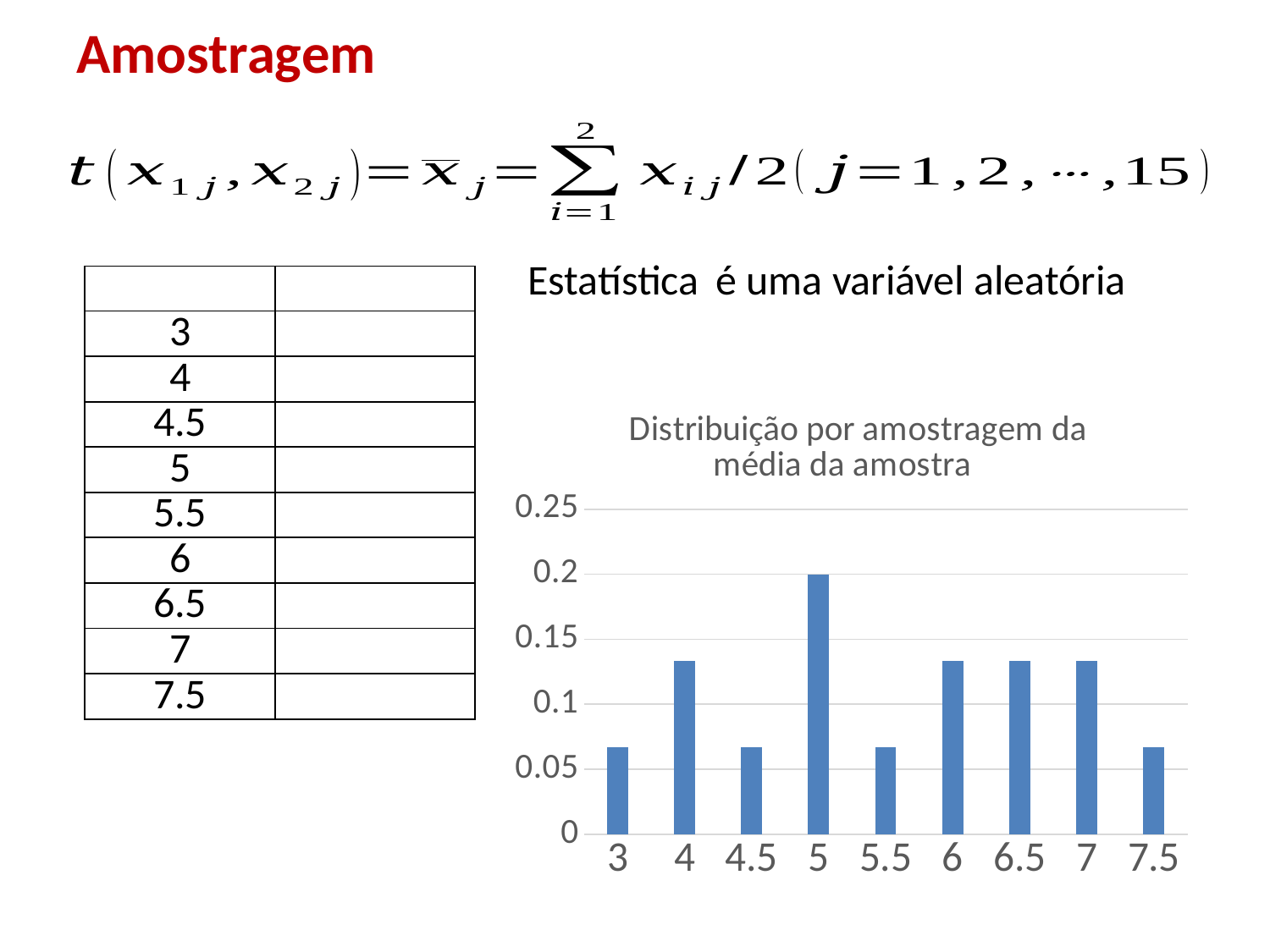
Is the value for category 4 greater or less than 0.1? greater Is the value for category 5 greater or less than 0.15? greater Which category has the highest bar in the chart? 5 Is the value for category 3 greater or less than 0.1? less How many categories are plotted on the x axis of the chart? 9 What is the title of the chart? Distribuição por amostragem da média da amostra What kind of chart is shown on the slide? bar chart Which has the larger value, category 3 or category 4? 4 Which has the larger value, category 5 or category 6.5? 5 What is the value for category 5 in the chart? 0.2